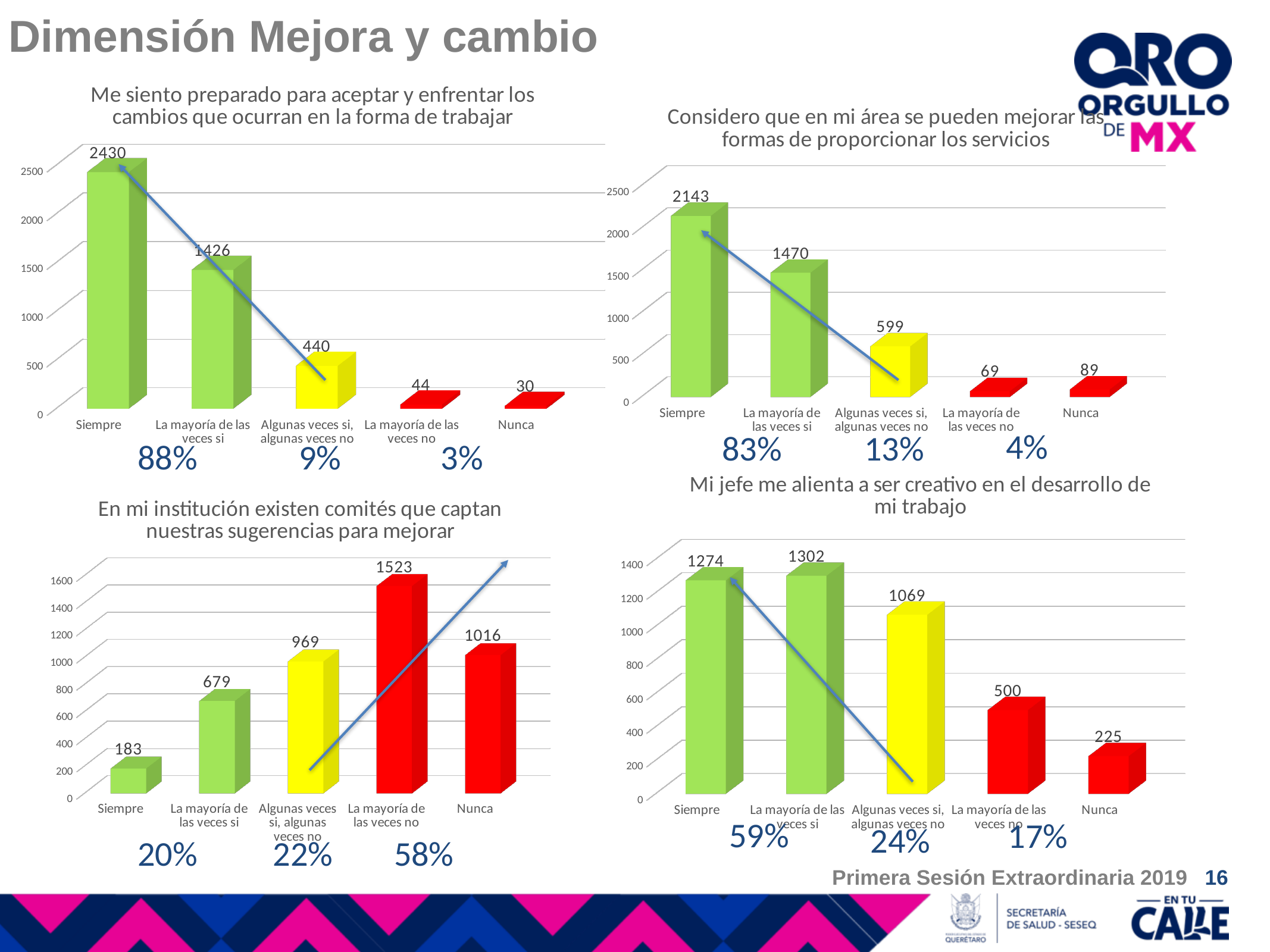
In the chart titled "Mi jefe me alienta a ser creativo en el desarrollo de mi trabajo", what is the difference between Algunas veces si, algunas veces no and La mayoría de las veces no? 569 In the chart titled "Mi jefe me alienta a ser creativo en el desarrollo de mi trabajo", what is the value for Nunca? 225 In the chart titled "Me siento preparado para aceptar y enfrentar los cambios que ocurran en la forma de trabajar", what is the value for Siempre? 2430 In the chart titled "En mi institución existen comités que captan nuestras sugerencias para mejorar", how many categories are shown on the x axis? 5 In the chart titled "Mi jefe me alienta a ser creativo en el desarrollo de mi trabajo", which category has the highest value? La mayoría de las veces si In the chart titled "En mi institución existen comités que captan nuestras sugerencias para mejorar", which category has the highest value? La mayoría de las veces no In the chart titled "Considero que en mi área se pueden mejorar las formas de proporcionar los servicios", what is the difference between Siempre and La mayoría de las veces si? 673 In the chart titled "En mi institución existen comités que captan nuestras sugerencias para mejorar", what is the value for Siempre? 183 What kind of chart is the one titled "Me siento preparado para aceptar y enfrentar los cambios que ocurran en la forma de trabajar"? Bar chart In the chart titled "Me siento preparado para aceptar y enfrentar los cambios que ocurran en la forma de trabajar", which category has the lowest value? Nunca In the chart titled "Considero que en mi área se pueden mejorar las formas de proporcionar los servicios", which is larger, La mayoría de las veces no or Nunca? Nunca In the chart titled "Considero que en mi área se pueden mejorar las formas de proporcionar los servicios", what is the value for Algunas veces si, algunas veces no? 599